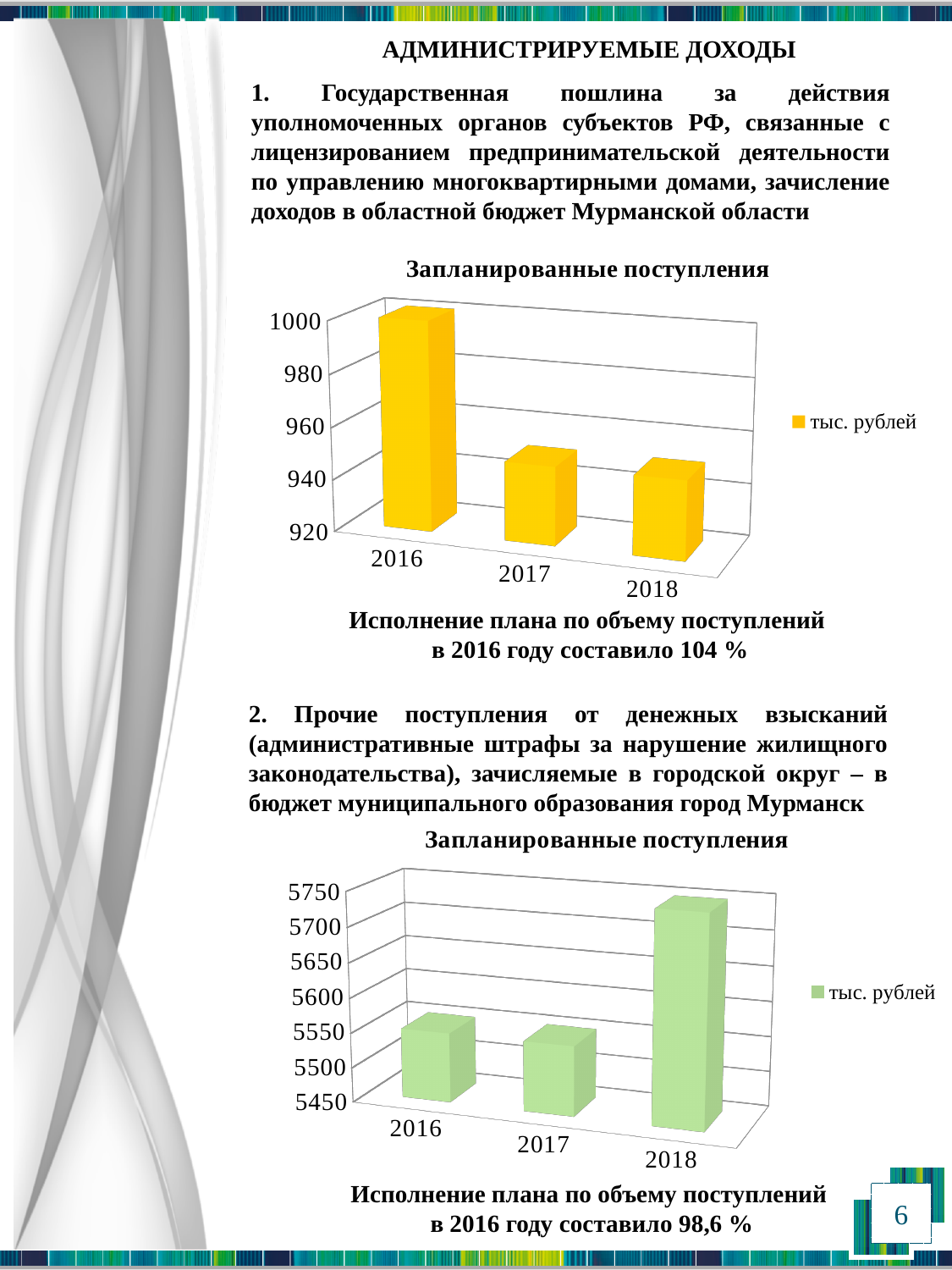
In the bottom chart (green bars), is the value for 2018 greater or less than 5650? greater How many series does the legend of the bottom chart (green bars) list? 1 In the top chart (yellow bars), is the value for 2016 larger than the value for 2018? yes In the bottom chart (green bars), which year has the highest planned revenue? 2018 In the bottom chart (green bars), does the value rise or fall from 2017 to 2018? rise In the top chart (yellow bars), do the values rise or fall from 2016 to 2018? fall In the top chart (yellow bars), is the value for 2017 greater or less than 960? less How many years are shown in the top chart (yellow bars)? 3 What type of chart is the top chart on the slide? bar chart In the bottom chart (green bars), is the value for 2016 greater or less than 5600? less In the top chart (yellow bars), which year has the highest planned revenue? 2016